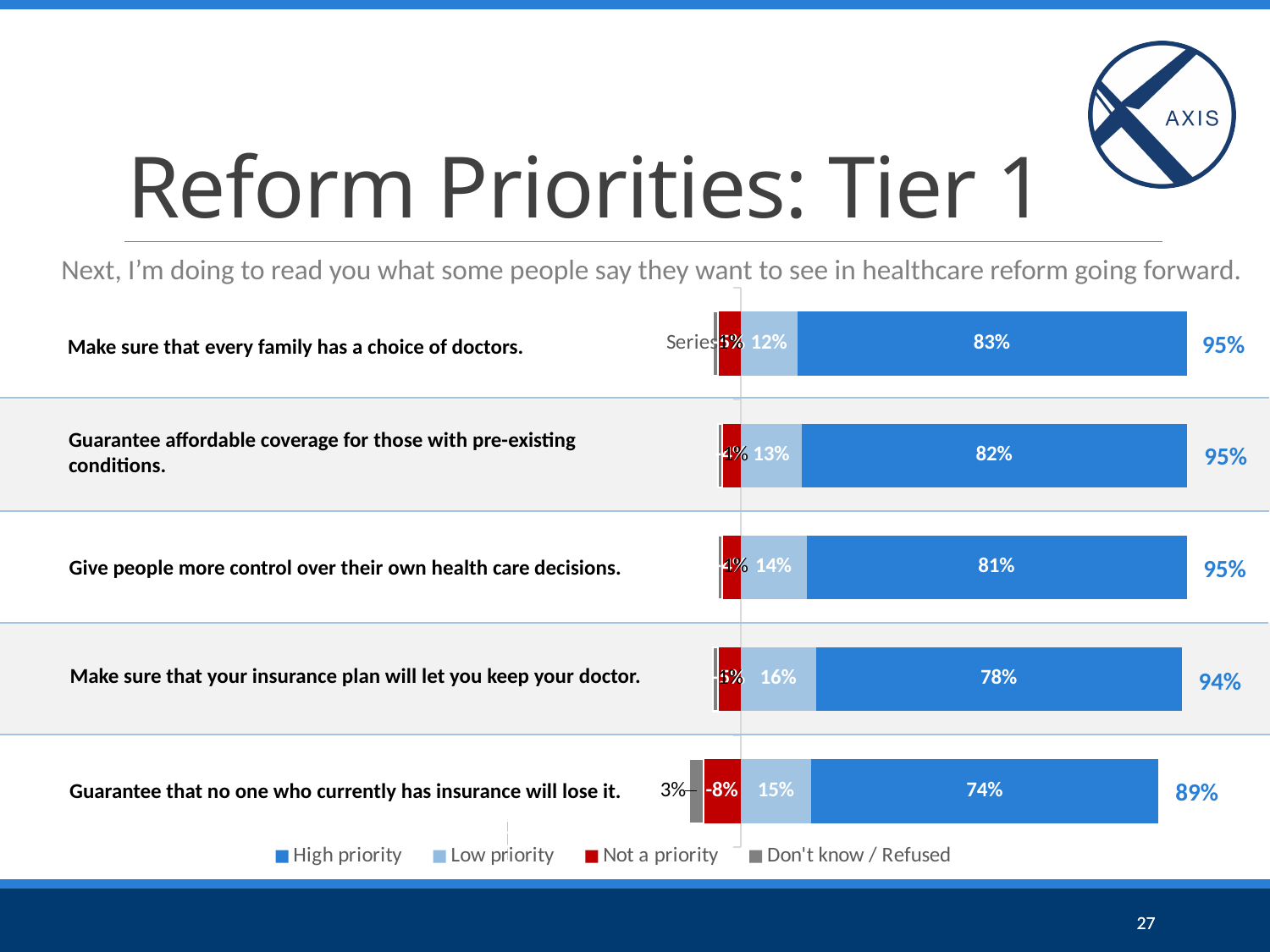
Which statement has the lowest high priority percentage? Guarantee that no one who currently has insurance will lose it. What is the difference between the high priority values for "Make sure that every family has a choice of doctors" (83%) and "Guarantee that no one who currently has insurance will lose it" (74%)? 9% What is the low priority value for "Make sure that your insurance plan will let you keep your doctor"? 16% What is the high priority value for "Guarantee that no one who currently has insurance will lose it"? 74% What percentage rated "Make sure that every family has a choice of doctors" as a high priority? 83% How many reform priority statements are plotted in the chart? 5 How many series does the legend list? 4 Which statement has the highest high priority percentage? Make sure that every family has a choice of doctors. What kind of chart is shown on the slide? stacked bar chart What is the "Not a priority" value shown for "Guarantee that no one who currently has insurance will lose it"? -8% Which has a larger high priority value: "Give people more control over their own health care decisions" or "Make sure that your insurance plan will let you keep your doctor"? Give people more control over their own health care decisions. What is the combined high and low priority total shown at the right for "Guarantee that no one who currently has insurance will lose it"? 89%